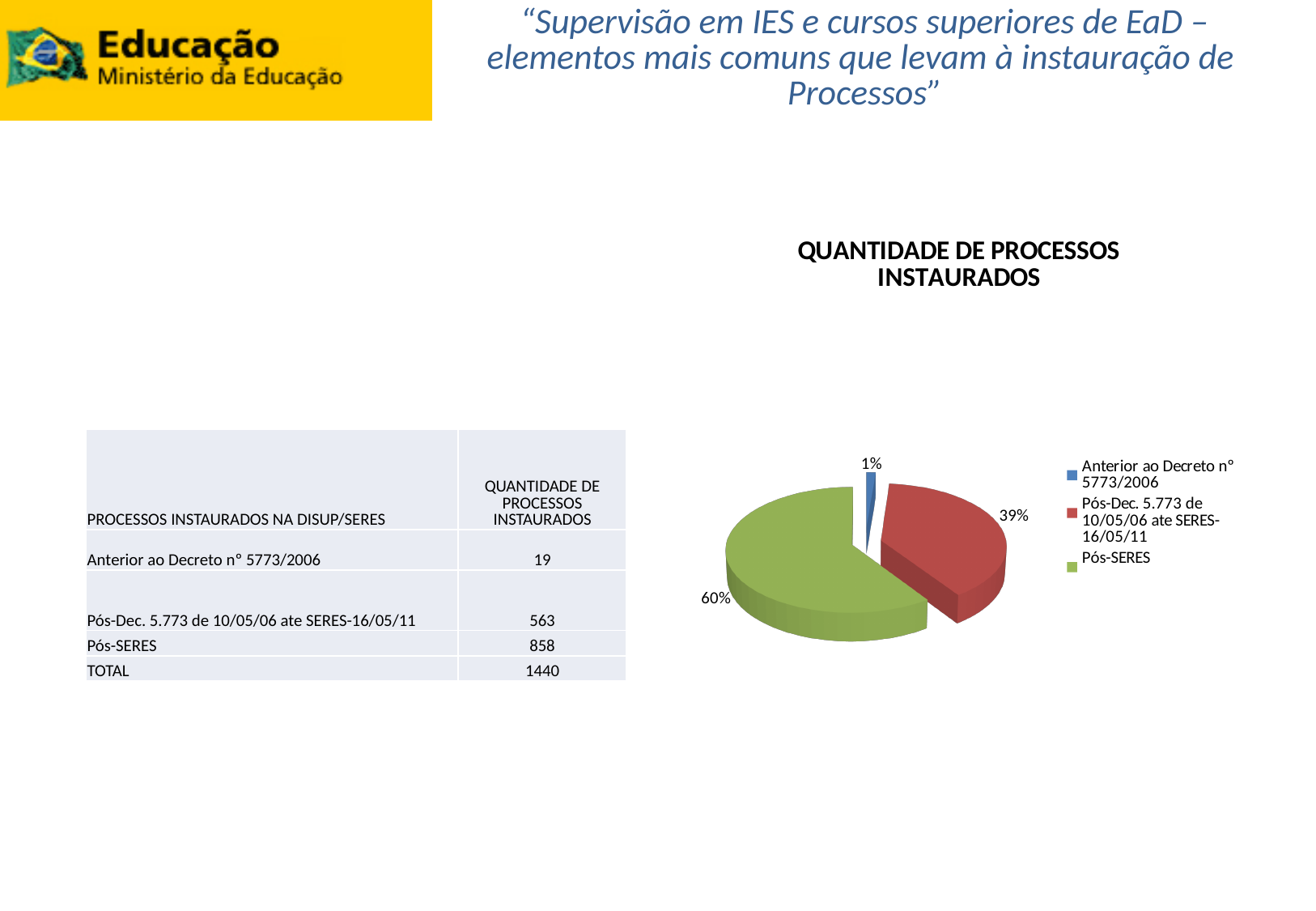
How many entries does the legend of the pie chart list? 3 What kind of chart is shown on the slide? pie chart What colour is the Pós-SERES slice in the pie chart? green How many slices does the pie chart have? 3 Which category has the largest slice of the pie? Pós-SERES By how many percentage points does the Pós-SERES share exceed the Pós-Dec. 5.773 de 10/05/06 ate SERES-16/05/11 share? 21 What share of the pie does Pós-SERES represent? 60% What is the title of the pie chart? QUANTIDADE DE PROCESSOS INSTAURADOS Which slice is larger: Pós-SERES or Pós-Dec. 5.773 de 10/05/06 ate SERES-16/05/11? Pós-SERES What share of the pie does Anterior ao Decreto n° 5773/2006 represent? 1% What share of the pie does Pós-Dec. 5.773 de 10/05/06 ate SERES-16/05/11 represent? 39% Which category has the smallest slice of the pie? Anterior ao Decreto n° 5773/2006